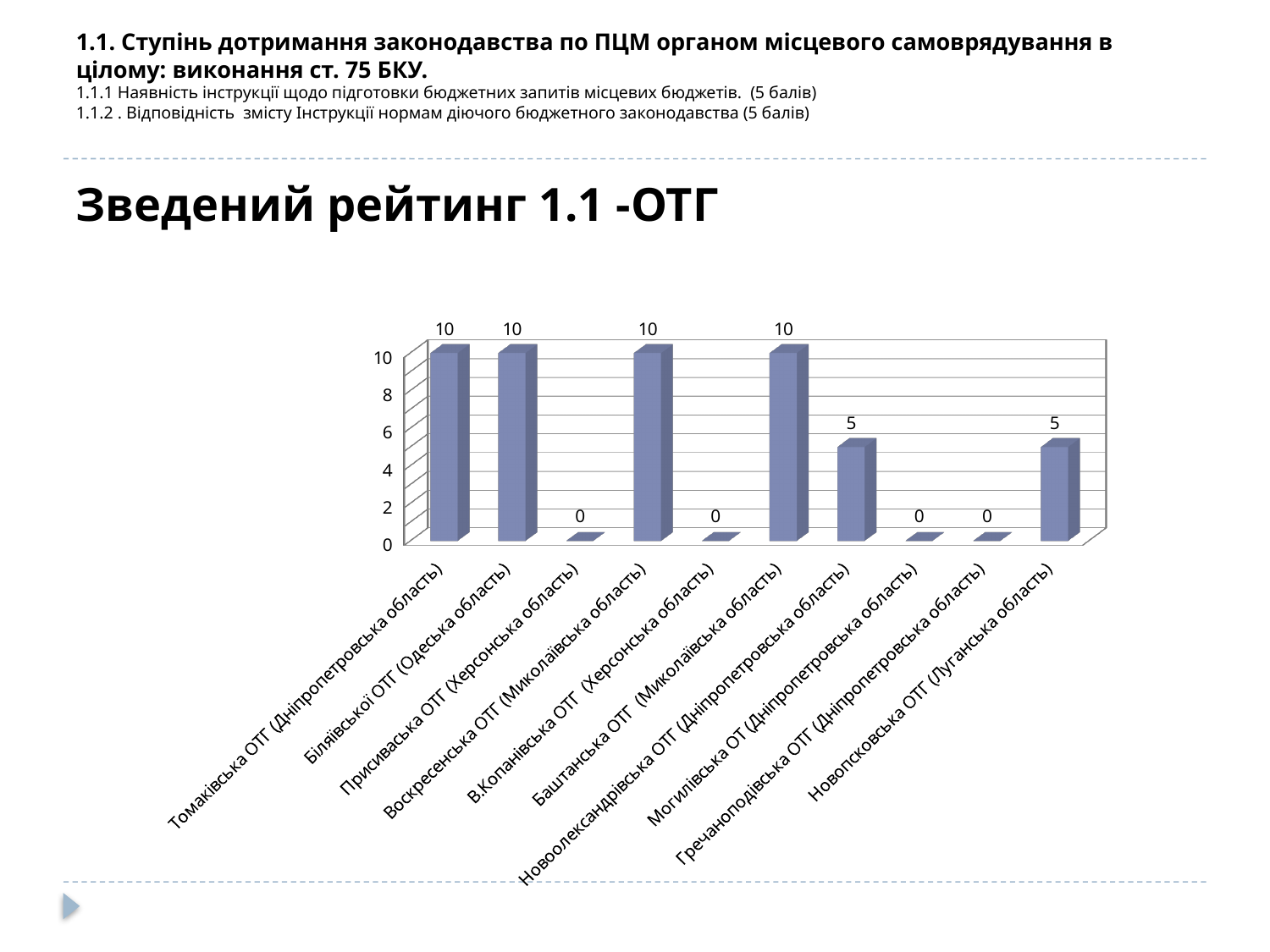
What is the title of the chart? Зведений рейтинг 1.1 -ОТГ What is the difference between the values for Воскресенська ОТГ (Миколаївська область) and Новопсковська ОТГ (Луганська область)? 5 What is the value for Баштанська ОТГ (Миколаївська область)? 10 What is the value for Присиваська ОТГ (Херсонська область)? 0 Which is larger, the value for Біляївської ОТГ (Одеська область) or the value for Новоолександрівська ОТГ (Дніпропетровська область)? Біляївської ОТГ (Одеська область) How many categories are shown on the x axis of the chart? 10 How many categories have a value of 0? 4 What is the value for Томаківська ОТГ (Дніпропетровська область)? 10 What is the value for Новопсковська ОТГ (Луганська область)? 5 What kind of chart is shown on the slide? Bar chart Which is larger, the value for Новопсковська ОТГ (Луганська область) or the value for Гречаноподівська ОТГ (Дніпропетровська область)? Новопсковська ОТГ (Луганська область) What is the value for Новоолександрівська ОТГ (Дніпропетровська область)? 5